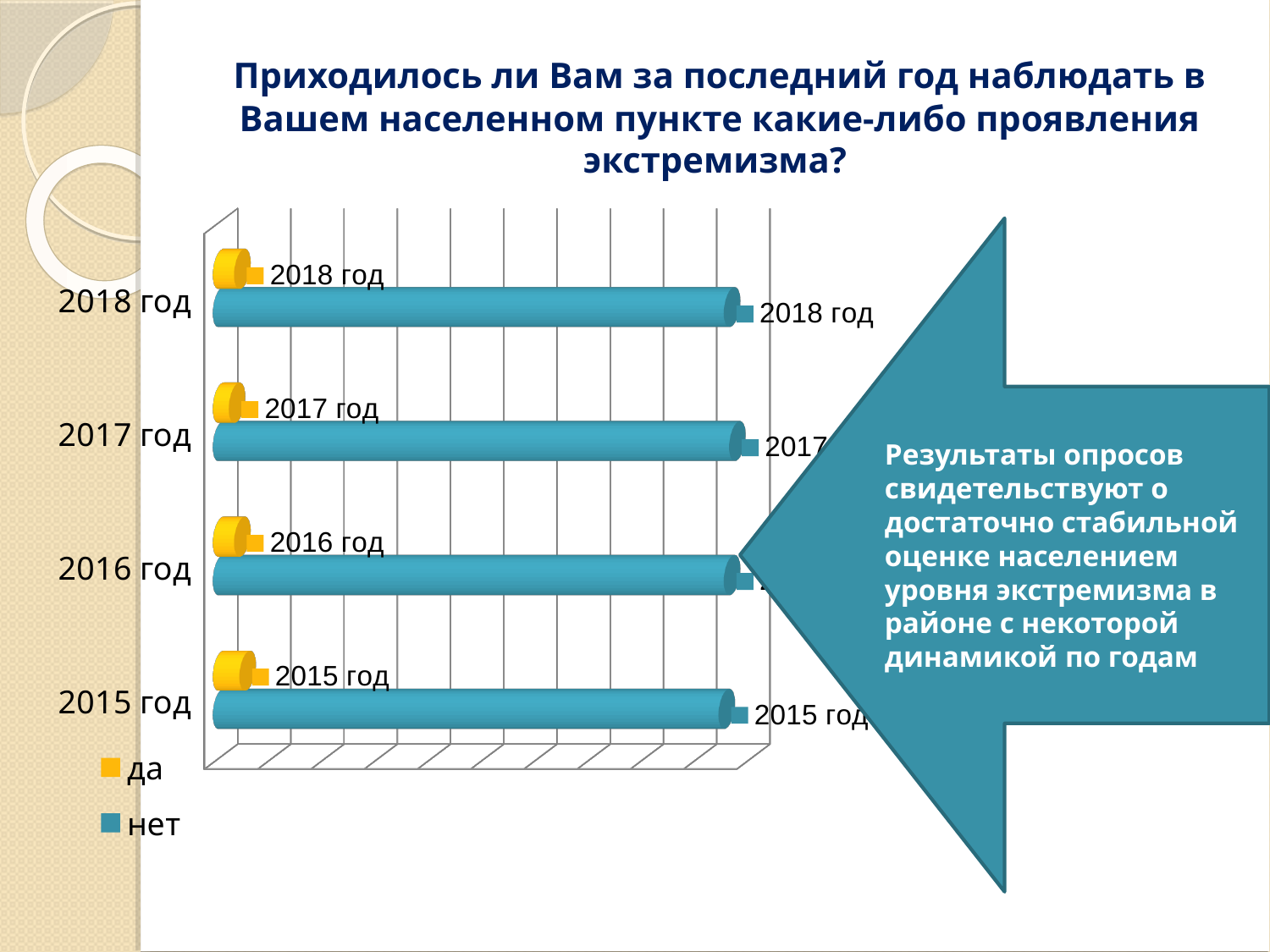
How many series does the legend list? 2 What are the two series listed in the legend? да, нет For 2018 год, which is larger: да or нет? нет Which series is shown in yellow? да For 2015 год, which is larger: да or нет? нет How many categories (years) are shown on the chart? 4 For 2017 год, which is larger: да or нет? нет Which year is listed at the top of the chart? 2018 год What kind of chart is shown on the slide? bar chart